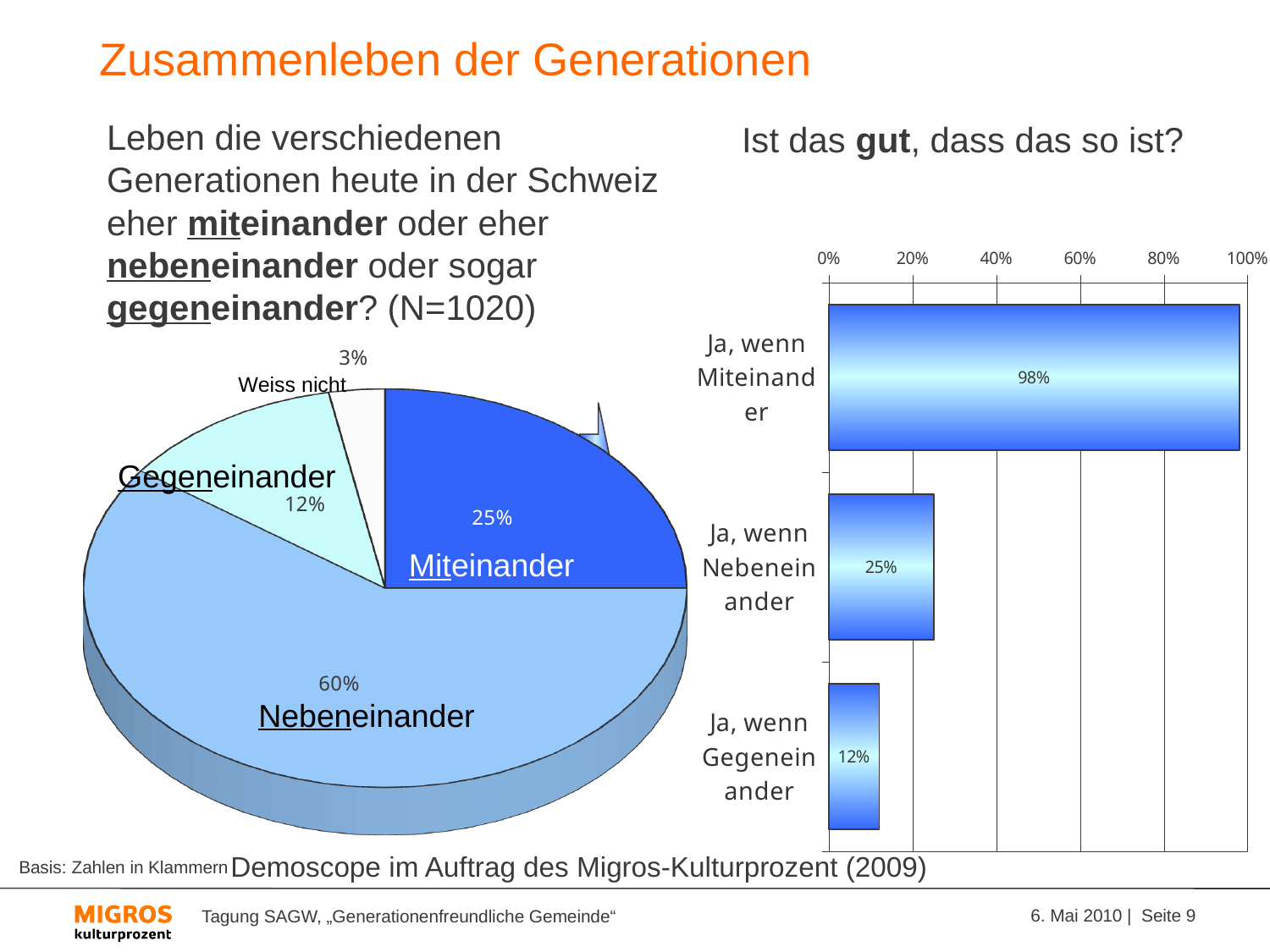
In the pie chart on the left, what share is labelled for Miteinander? 25% In the pie chart on the left, which category has the largest slice? Nebeneinander In the pie chart on the left, how many slices are there? 4 In the bar chart on the right, which category has the lowest value? Ja, wenn Gegeneinander What kind of chart is shown on the right side of the slide? Bar chart In the bar chart on the right, what is the value for 'Ja, wenn Miteinander'? 98% In the pie chart on the left, what share is labelled for Nebeneinander? 60% In the pie chart on the left, what is the difference between the Nebeneinander and Gegeneinander shares? 48% In the bar chart on the right, what is the value for 'Ja, wenn Gegeneinander'? 12% In the pie chart on the left, which category has the smallest slice? Weiss nicht In the pie chart on the left, what share is labelled for Weiss nicht? 3% In the bar chart on the right, what is the difference between 'Ja, wenn Miteinander' and 'Ja, wenn Nebeneinander'? 73%